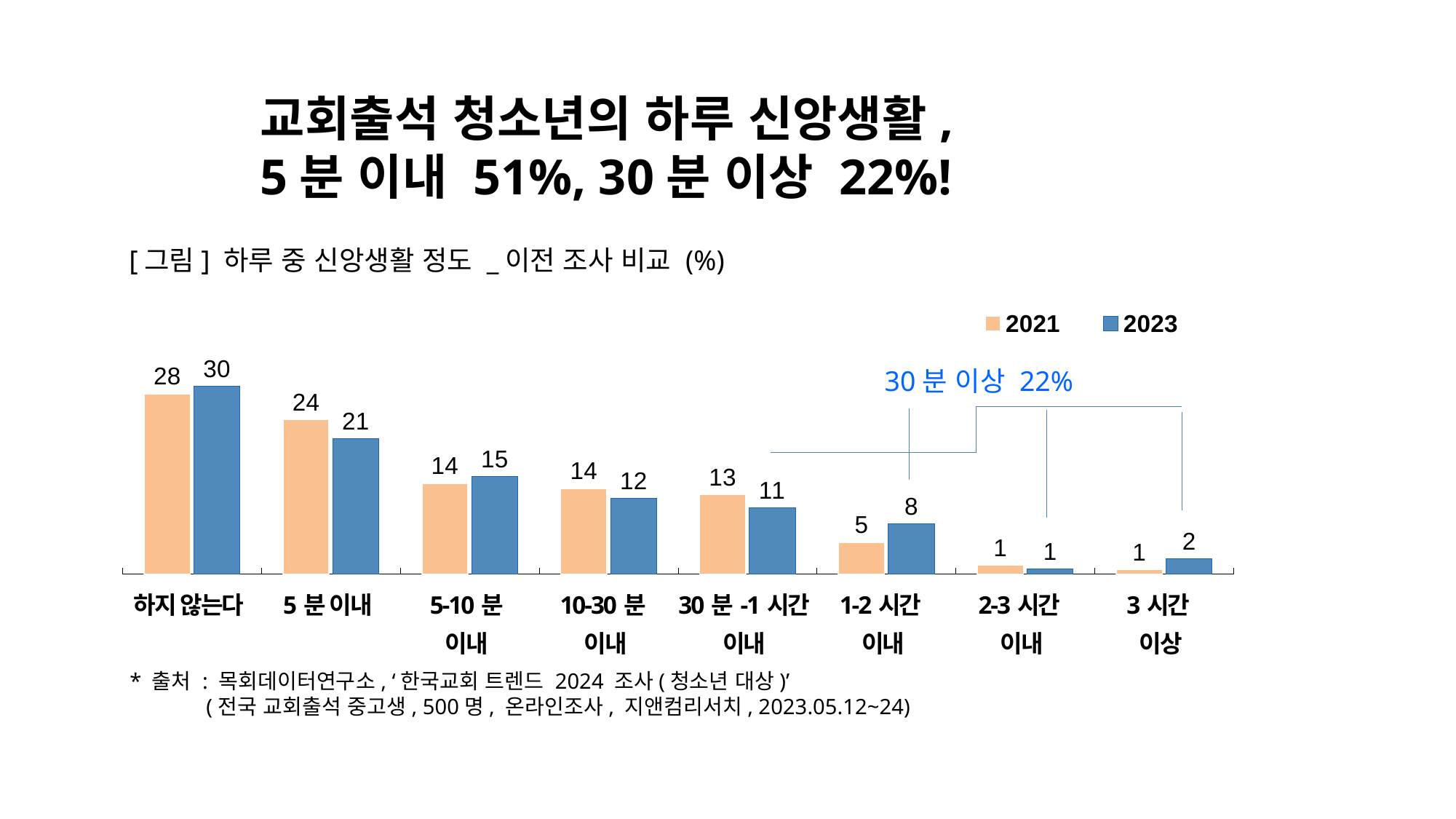
Which category has the lowest 2023 value? 2-3 시간 이내 Which is larger for 30 분 -1 시간 이내, the 2021 value or the 2023 value? 2021 How many series does the legend list? 2 What is the difference between the 2021 and 2023 values for 1-2 시간 이내? 3 What is the 2021 value for 5 분 이내? 24 Which category has the highest 2023 value? 하지 않는다 Which series is shown in blue in the legend? 2023 What kind of chart is shown on the slide? bar chart What is the 2023 value for 하지 않는다? 30 What is the 2023 value for 1-2 시간 이내? 8 What is the difference between the 2021 and 2023 values for 5 분 이내? 3 How many categories are shown on the x axis? 8